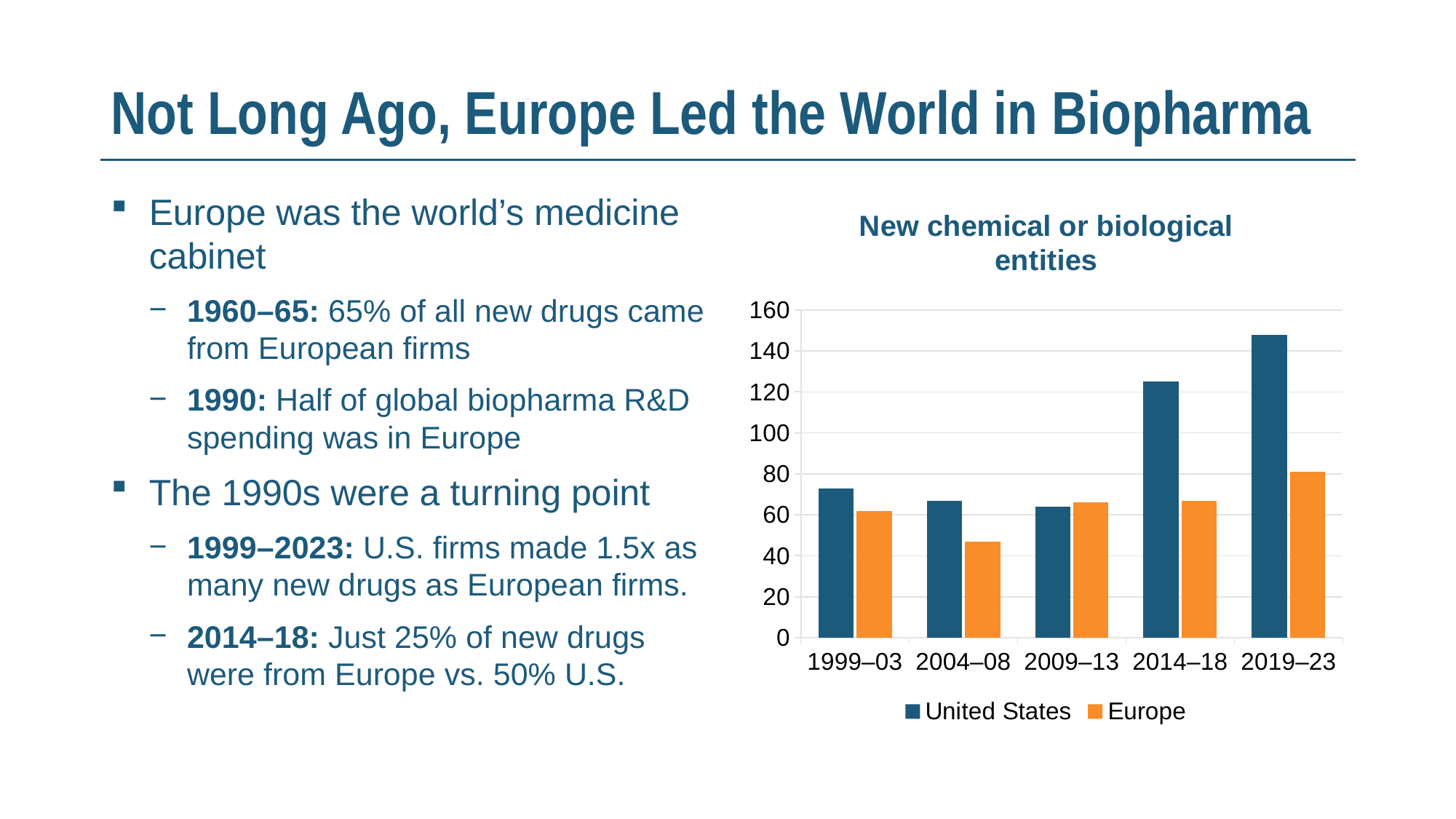
How many time periods are shown on the x axis of the chart? 5 Is the United States value for 2014–18 greater or less than 100? greater In which period is the United States value highest? 2019–23 What kind of chart is shown on the slide? bar chart Is the Europe value for 2004–08 greater or less than 60? less Which series is shown in orange in the chart? Europe How many series does the chart's legend list? 2 Do the United States values rise or fall from 2009–13 to 2019–23? rise Is the United States value for 2019–23 greater or less than 140? greater In which period is the Europe value lowest? 2004–08 What is the title of the chart? New chemical or biological entities In 2014–18, which is larger: the United States value or the Europe value? United States